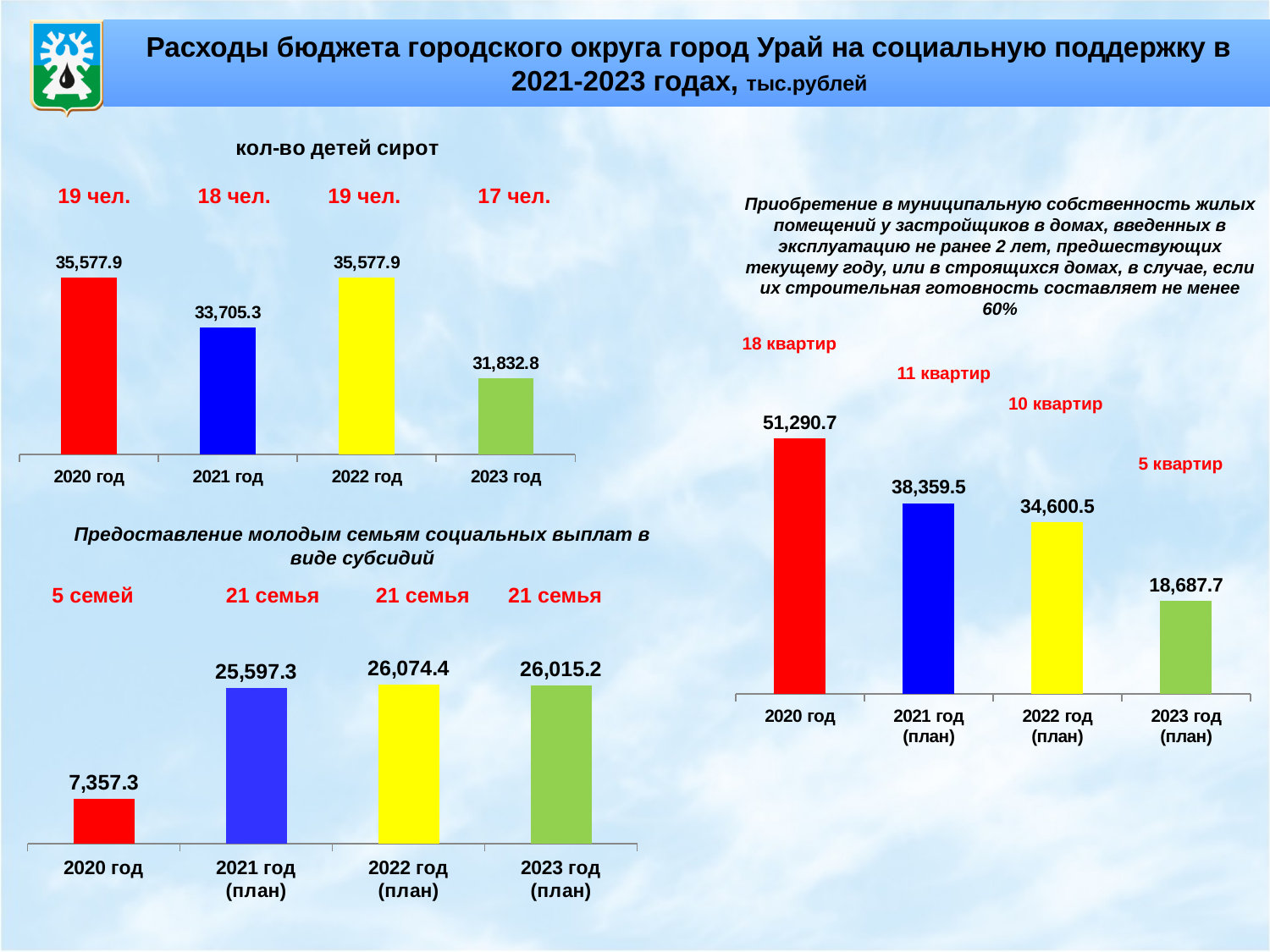
On the chart titled 'кол-во детей сирот', which year has the lowest value? 2023 год On the chart on the right about 'Приобретение в муниципальную собственность жилых помещений', what is the value for 2022 год (план)? 34,600.5 On the chart on the right about 'Приобретение в муниципальную собственность жилых помещений', do the values rise or fall from 2020 to 2023? fall On the chart titled 'Предоставление молодым семьям социальных выплат в виде субсидий', what is the difference between the values for 2021 год (план) and 2020 год? 18,240.0 On the chart titled 'Предоставление молодым семьям социальных выплат в виде субсидий', which year has the lowest value? 2020 год On the chart titled 'кол-во детей сирот', what is the difference between the values for 2020 год and 2023 год? 3,745.1 What type of chart is the chart titled 'кол-во детей сирот'? bar chart On the chart on the right about 'Приобретение в муниципальную собственность жилых помещений', which year has the highest value? 2020 год On the chart titled 'кол-во детей сирот', how many bars are plotted? 4 On the chart titled 'кол-во детей сирот', what is the value for 2021 год? 33,705.3 On the chart on the right about 'Приобретение в муниципальную собственность жилых помещений', what is the difference between the values for 2020 год and 2023 год (план)? 32,603.0 On the chart titled 'Предоставление молодым семьям социальных выплат в виде субсидий', what is the value for 2020 год? 7,357.3